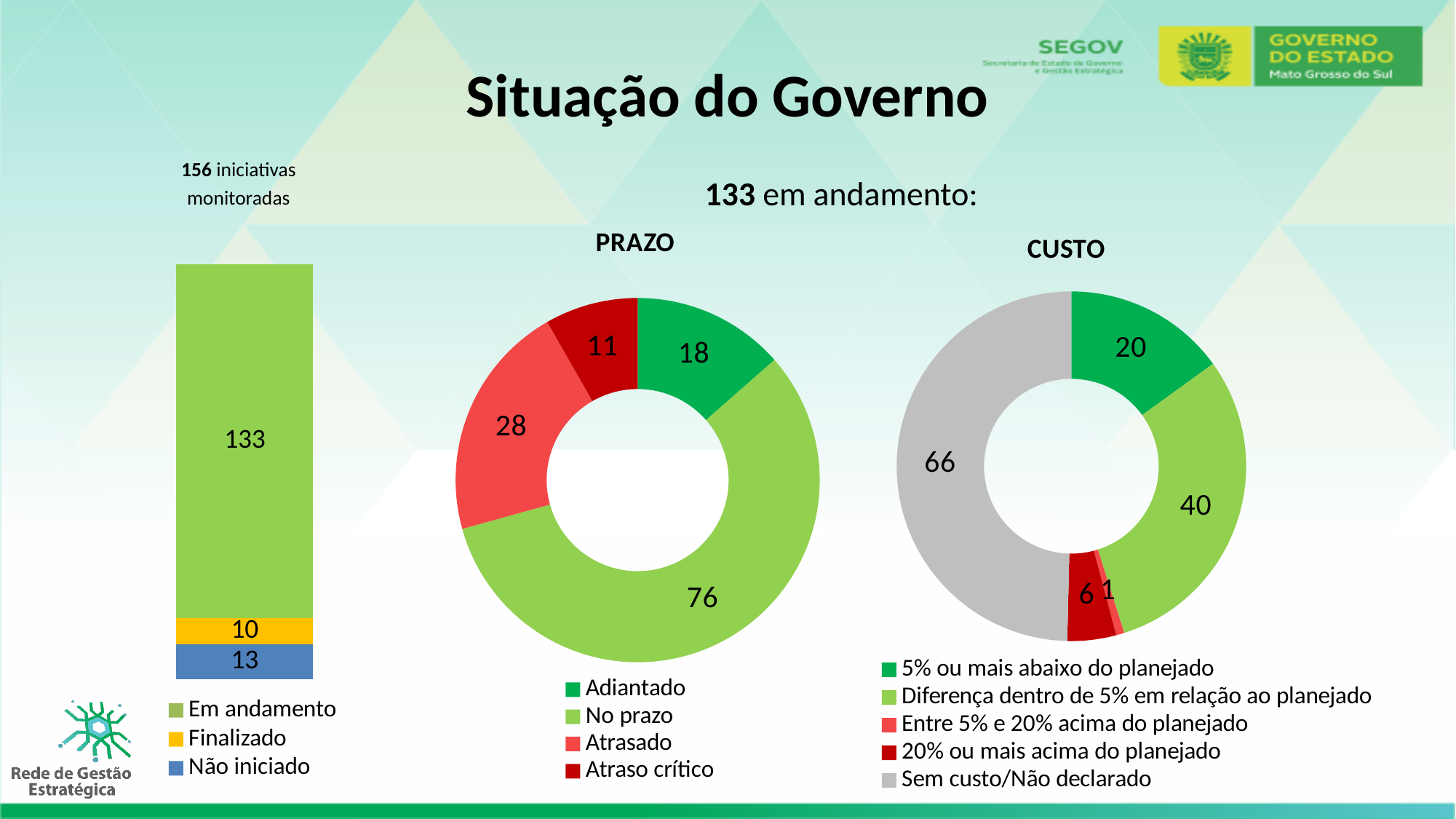
In the stacked bar chart on the left, what is the difference between "Não iniciado" and "Finalizado"? 3 In the stacked bar chart on the left, what is the total of the stacked bar? 156 In the CUSTO chart, what is the value for "Sem custo/Não declarado"? 66 In the CUSTO chart, what is the difference between "Diferença dentro de 5% em relação ao planejado" and "5% ou mais abaixo do planejado"? 20 In the stacked bar chart on the left, what is the value for "Em andamento"? 133 In the PRAZO chart, which category has the highest value? No prazo In the CUSTO chart, which is larger: "5% ou mais abaixo do planejado" or "20% ou mais acima do planejado"? 5% ou mais abaixo do planejado What kind of chart is the CUSTO chart? Donut chart In the PRAZO chart, which category has the lowest value? Atraso crítico In the stacked bar chart on the left, which segment is the smallest? Finalizado In the PRAZO chart, what is the value for "Atrasado"? 28 In the PRAZO chart, how many categories does the legend list? 4